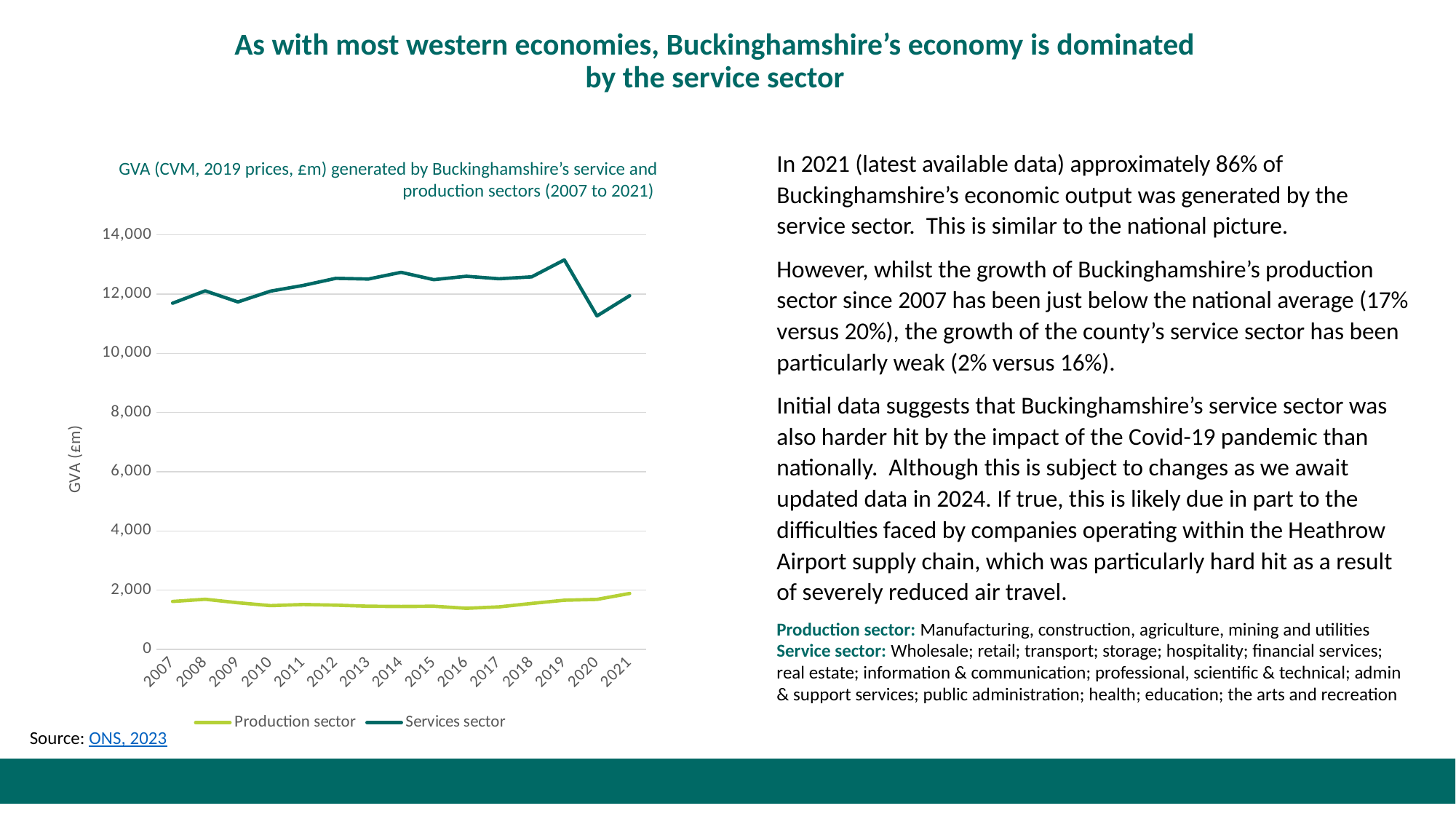
What kind of chart is shown on the slide? Line chart What is the label on the chart's y axis? GVA (£m) Is the value for the Production sector in 2007 greater or less than 2,000? less Is the value for the Services sector in 2019 greater or less than 12,000? greater Which series is drawn in the light green colour in the chart? Production sector Is the value for the Services sector in 2020 greater or less than 12,000? less How many years are plotted along the x axis of the chart? 15 Which series has the larger value in 2021, Production sector or Services sector? Services sector How many series does the chart's legend list? 2 In which year does the Services sector line reach its highest value? 2019 In which year does the Services sector line reach its lowest value? 2020 Does the Services sector line rise or fall between 2019 and 2020? Fall